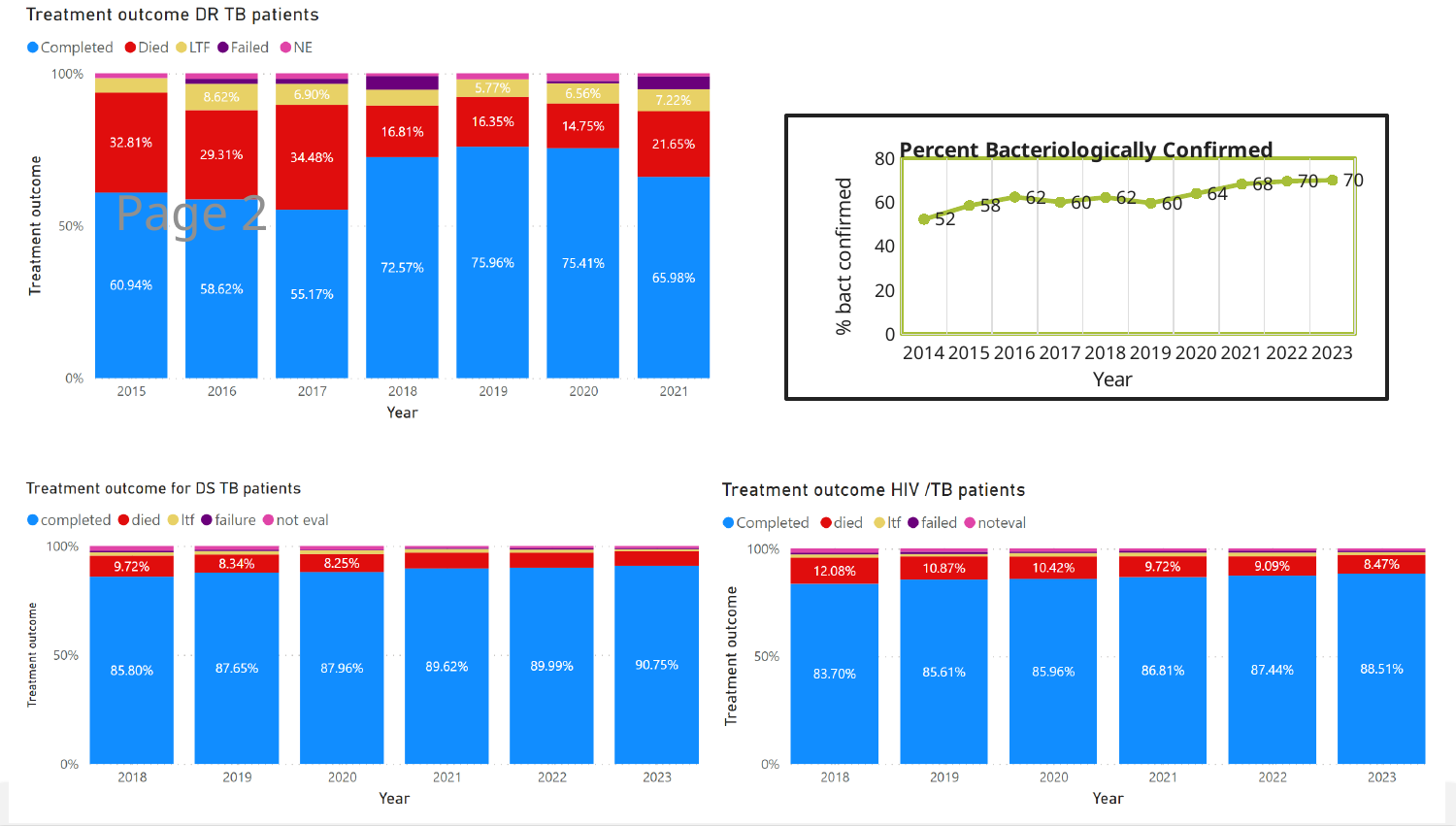
What kind of chart is 'Percent Bacteriologically Confirmed'? Line chart In the 'Percent Bacteriologically Confirmed' chart, which year has the lowest value? 2014 How many years are plotted in the 'Percent Bacteriologically Confirmed' chart? 10 How many series does the legend of the 'Treatment outcome DR TB patients' chart list? 5 In the 'Treatment outcome HIV /TB patients' chart, what is the died percentage for 2018? 12.08% In the 'Treatment outcome DR TB patients' chart, what is the Completed percentage for 2018? 72.57% In the 'Treatment outcome for DS TB patients' chart, do the completed percentages rise or fall from 2018 to 2023? Rise In the 'Treatment outcome DR TB patients' chart, which year has the highest Died percentage? 2017 In the 'Percent Bacteriologically Confirmed' chart, what is the value for 2021? 68 In the 'Treatment outcome for DS TB patients' chart, what is the completed percentage for 2023? 90.75% In the 'Treatment outcome DR TB patients' chart, what is the difference between the Died percentages for 2015 and 2016? 3.50% In the 'Treatment outcome HIV /TB patients' chart, which is larger: the Completed percentage for 2019 or for 2022? 2022